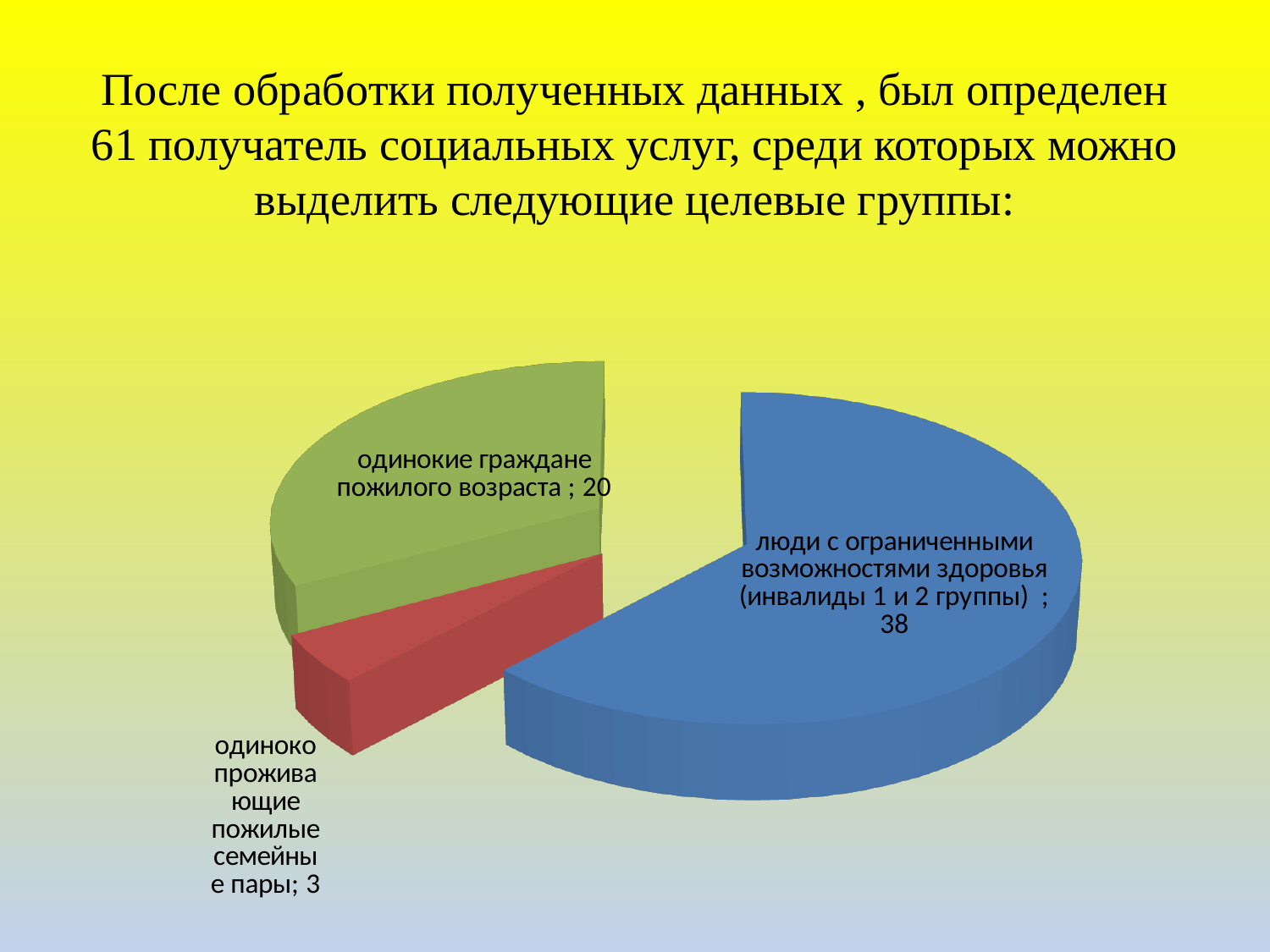
What is the value for люди с ограниченными возможностями здоровья (инвалиды 1 и 2 группы)? 38 What is the difference between the values for одинокие граждане пожилого возраста and одиноко проживающие пожилые семейные пары? 17 What colour is the slice for одинокие граждане пожилого возраста? green Which category has the largest slice of the pie? люди с ограниченными возможностями здоровья (инвалиды 1 и 2 группы) What kind of chart is shown on the slide? pie chart How many slices does the pie chart have? 3 What is the total of all slices in the pie chart? 61 Which category has the smallest slice of the pie? одиноко проживающие пожилые семейные пары What is the difference between the values for люди с ограниченными возможностями здоровья and одинокие граждане пожилого возраста? 18 What is the value for одиноко проживающие пожилые семейные пары? 3 Which is larger: the value for одинокие граждане пожилого возраста or for одиноко проживающие пожилые семейные пары? одинокие граждане пожилого возраста What is the value for одинокие граждане пожилого возраста? 20